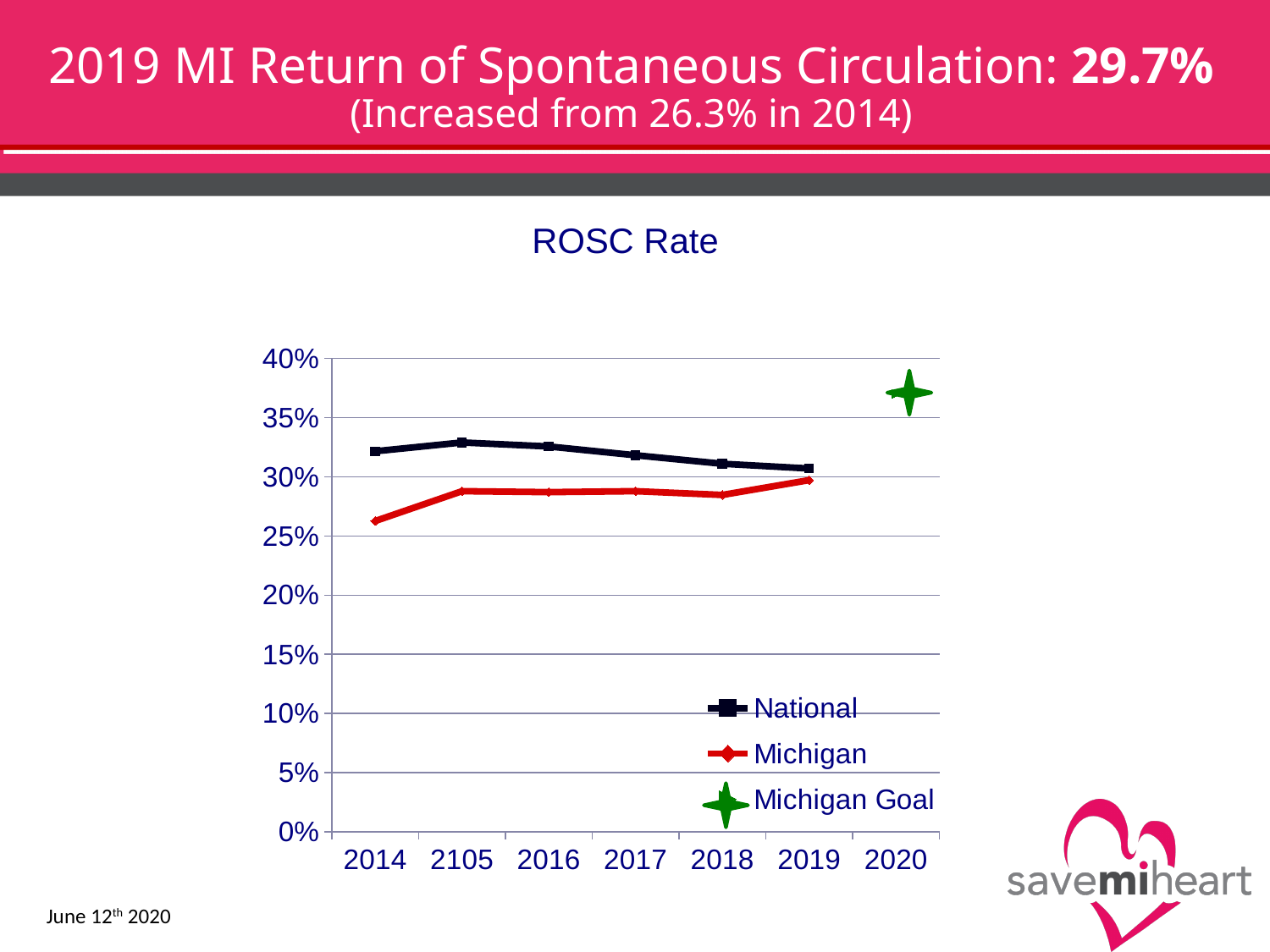
How many series does the chart legend list? 3 Is the National value for 2014 greater or less than 30%? greater By how much did the Michigan ROSC rate increase from 2014 to 2019? 3.4 percentage points What kind of chart is shown on the slide? line chart What is the title of the chart? ROSC Rate Which series are listed in the chart legend? National, Michigan, Michigan Goal What is the Michigan ROSC rate for 2019? 29.7% In which year is the Michigan series at its lowest? 2014 In 2016, which series has the higher value, National or Michigan? National Is the Michigan Goal value for 2020 greater or less than 35%? greater What was the Michigan ROSC rate in 2014? 26.3% How many year labels are shown on the x axis of the chart? 7